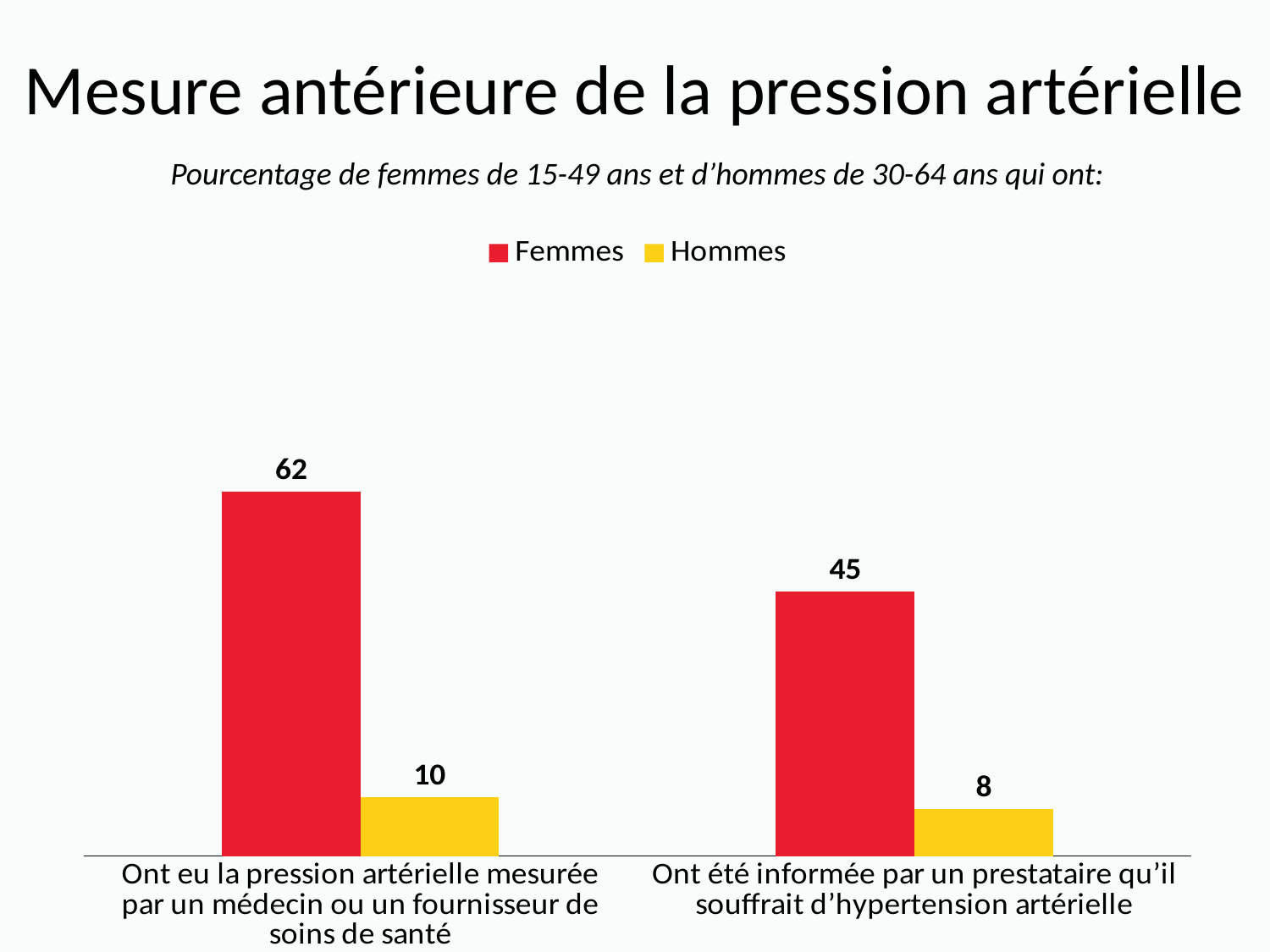
What is the value for Hommes in the category 'Ont eu la pression artérielle mesurée par un médecin ou un fournisseur de soins de santé'? 10 What kind of chart is shown on the slide? Bar chart How many categories are shown on the x axis? 2 What percentage of women had their blood pressure measured by a doctor or health care provider? 62 What is the value for Femmes in the category 'Ont été informée par un prestataire qu'il souffrait d'hypertension artérielle'? 45 What is the value for Hommes in the category 'Ont été informée par un prestataire qu'il souffrait d'hypertension artérielle'? 8 Which is larger: the Hommes value for having blood pressure measured, or the Hommes value for being informed of hypertension? Having blood pressure measured (10) Which series has the highest value on the chart? Femmes Which bar has the lowest value on the chart? Hommes, Ont été informée par un prestataire qu'il souffrait d'hypertension artérielle How many series does the legend list? 2 What is the difference between the Femmes and Hommes values for having blood pressure measured by a doctor or health care provider? 52 What is the difference between the Femmes values for the two categories? 17